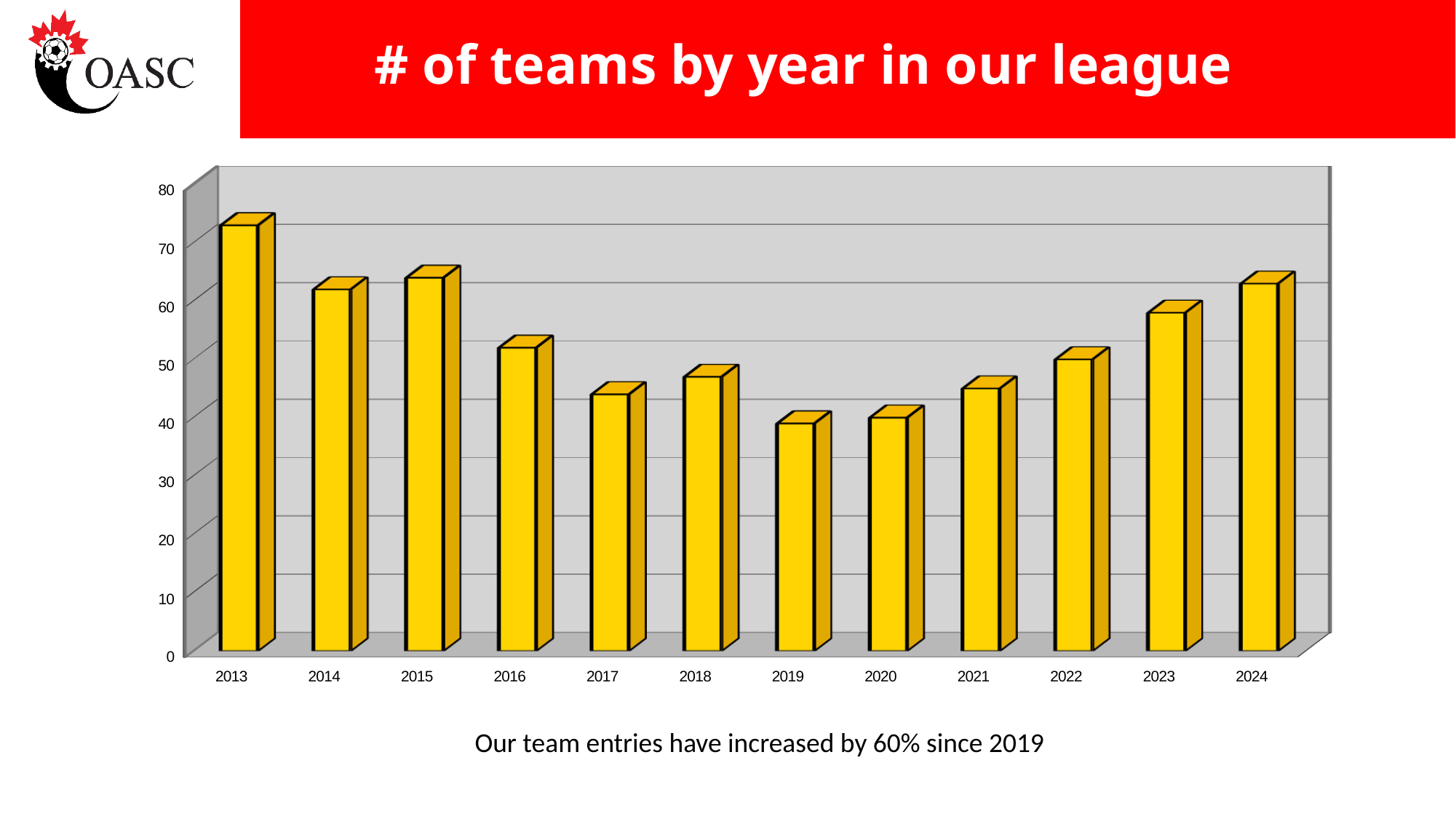
Which year has more teams, 2013 or 2024? 2013 Which year has the highest number of teams? 2013 Is the value for 2017 greater or less than 50? less Is the value for 2024 greater or less than 60? greater Is the value for 2013 greater or less than 70? greater How many years are shown on the x axis of the chart? 12 Do the values rise or fall from 2019 to 2024? rise What kind of chart is shown on the slide? bar chart What is the title of the chart? # of teams by year in our league Which year has more teams, 2015 or 2016? 2015